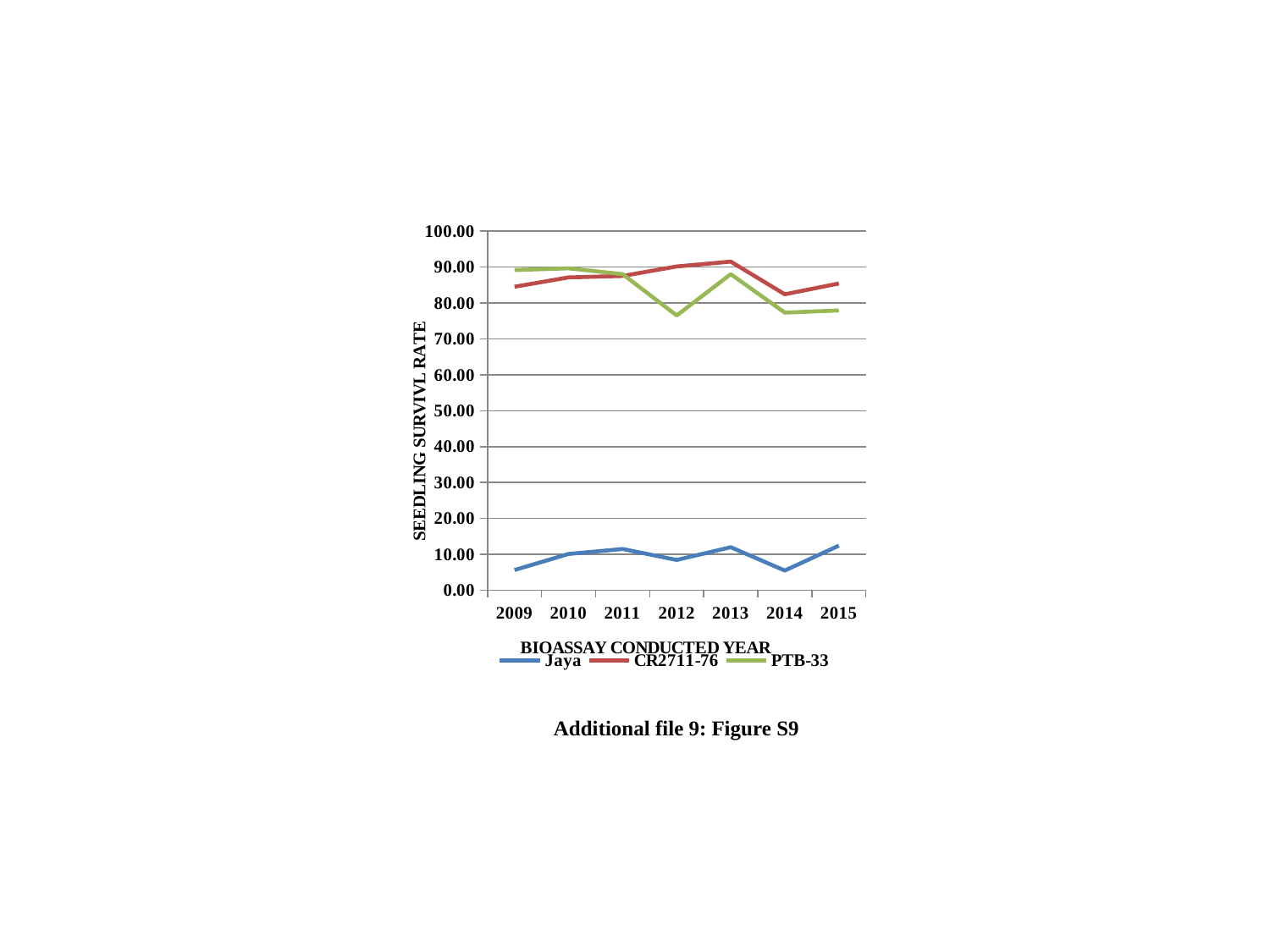
How many series does the legend list? 3 Is the value for Jaya in 2009 greater or less than 10.00? less Is the value for CR2711-76 in 2012 greater or less than 80.00? greater What kind of chart is shown on the slide? line chart Is the value for PTB-33 in 2012 greater or less than 80.00? less What is the title of the x axis? BIOASSAY CONDUCTED YEAR How many years are plotted along the x axis? 7 Which series has the lowest values across all years? Jaya In 2012, which series has the higher value, CR2711-76 or PTB-33? CR2711-76 In 2009, which series has the higher value, PTB-33 or CR2711-76? PTB-33 Does the PTB-33 line rise or fall from 2011 to 2012? fall